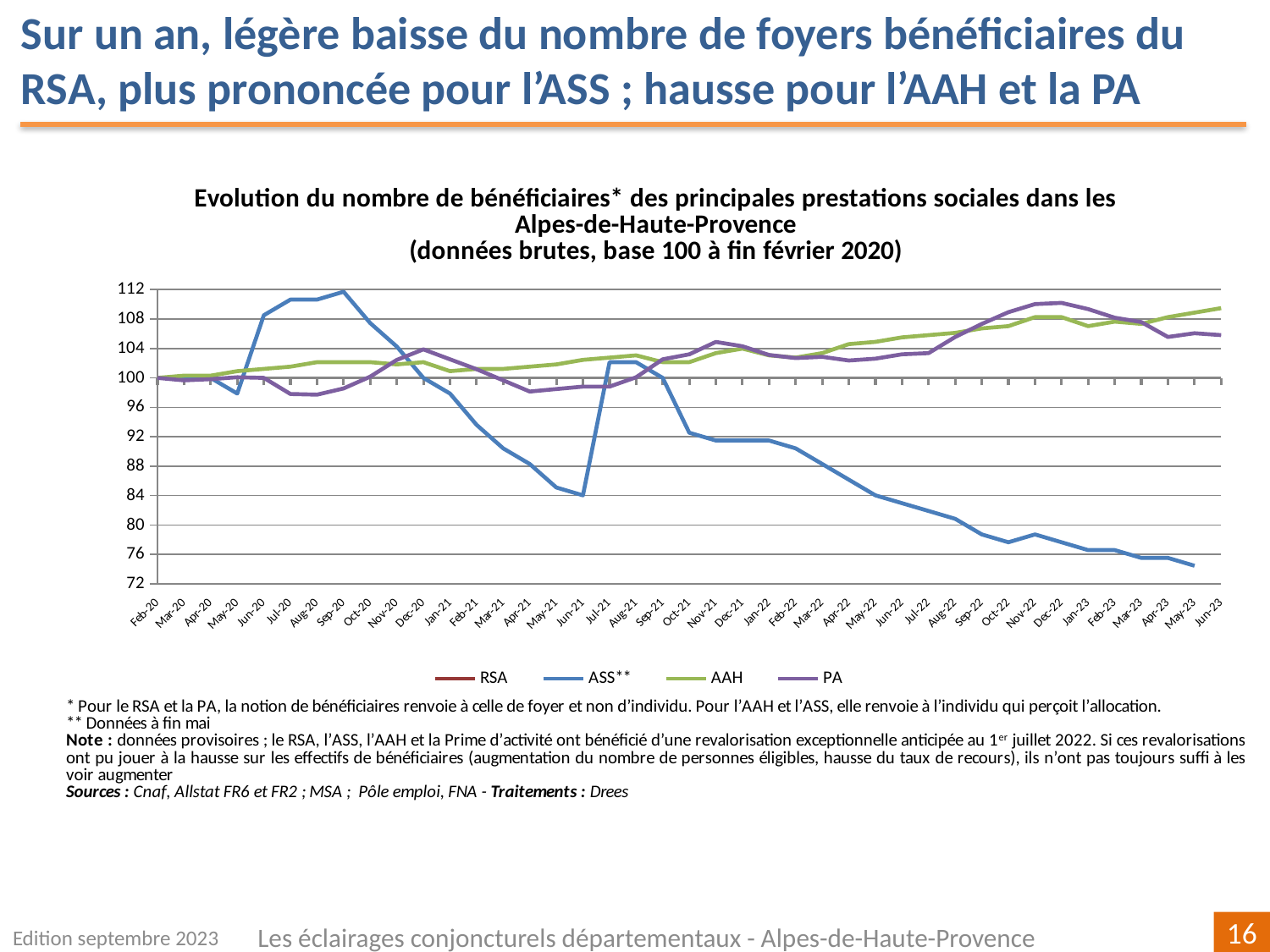
What is the value of the AAH series at Feb-20? 100 What is the title of the chart? Evolution du nombre de bénéficiaires* des principales prestations sociales dans les Alpes-de-Haute-Provence (données brutes, base 100 à fin février 2020) What kind of chart is shown on the slide? line chart Is the value for AAH at Jun-23 greater or less than 104? greater Is the value for ASS** at Jun-21 greater or less than 88? less Is the value for ASS** at Sep-20 greater or less than 108? greater How many series does the chart legend list? 4